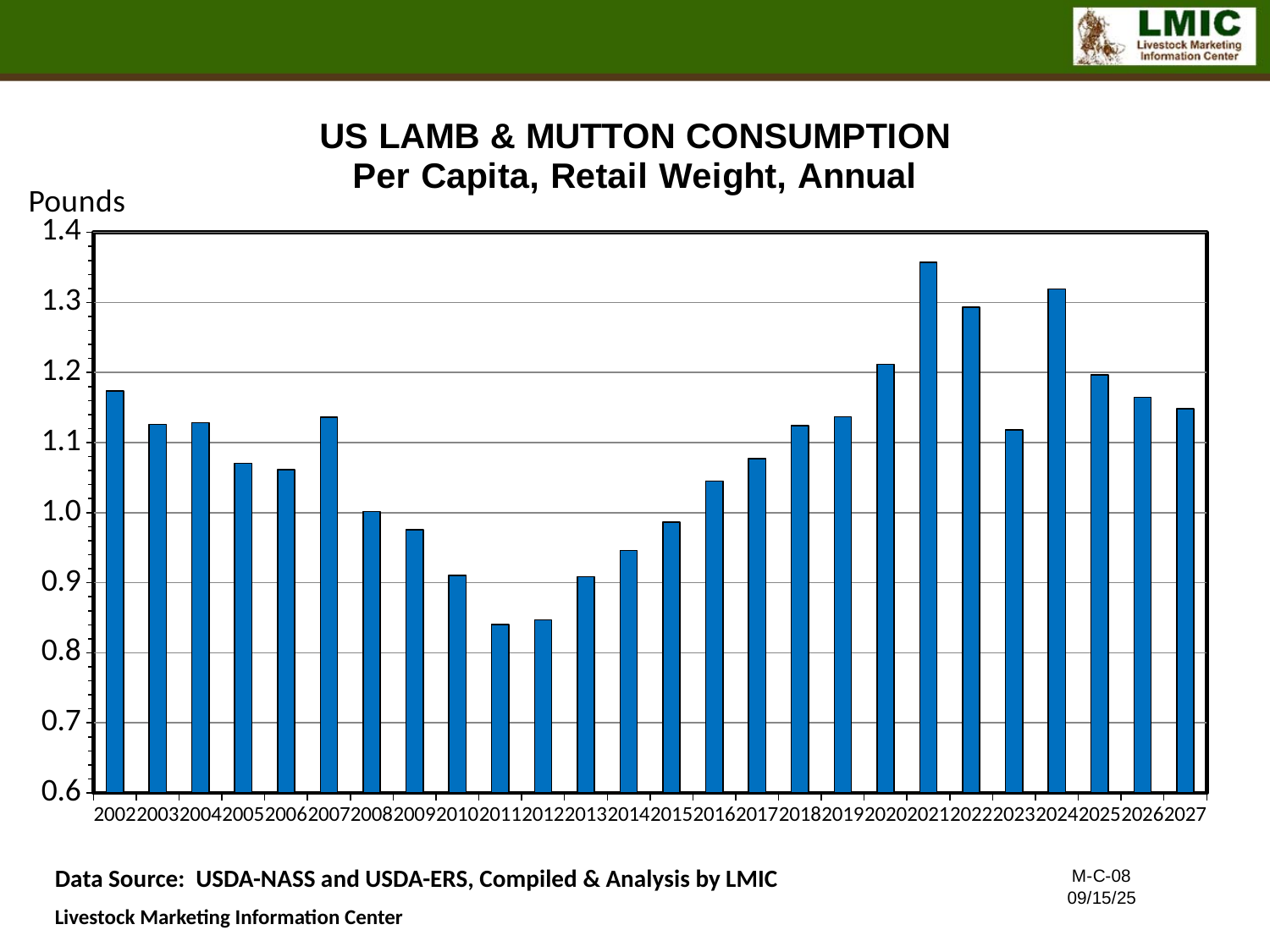
Is the value for 2021 greater or less than 1.3? greater Is the value for 2005 greater or less than 1.0? greater Do the values generally rise or fall from 2011 to 2021? rise Which is larger, the value for 2002 or the value for 2011? 2002 How many years (bars) are plotted on the chart? 26 What kind of chart is shown on the slide? bar chart Is the value for 2011 greater or less than 0.9? less Which year has the highest per capita lamb and mutton consumption? 2021 What unit is shown on the vertical axis of the chart? Pounds Which is larger, the value for 2022 or the value for 2023? 2022